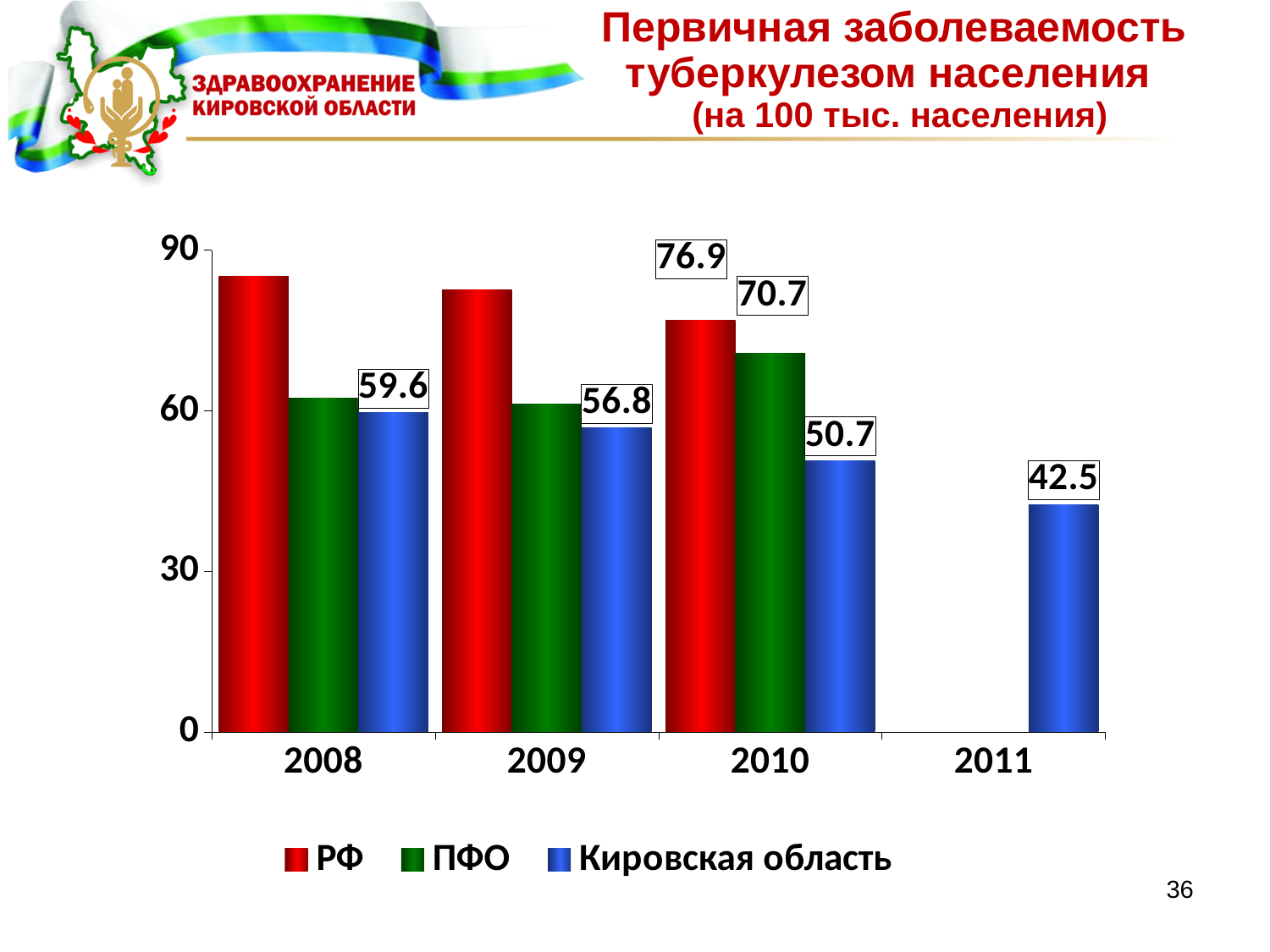
How many series does the legend list? 3 Is the value for РФ in 2008 greater or less than 60? greater What is the difference between the РФ value and the Кировская область value in 2010? 26.2 What is the value for Кировская область in 2008? 59.6 What is the value for ПФО in 2010? 70.7 What is the value for РФ in 2010? 76.9 What kind of chart is shown on the slide? bar chart What is the value for Кировская область in 2011? 42.5 Do the values for Кировская область rise or fall from 2008 to 2011? fall In which year is the Кировская область value highest? 2008 How many years are shown on the x axis? 4 By how much did the Кировская область value fall from 2008 to 2011? 17.1